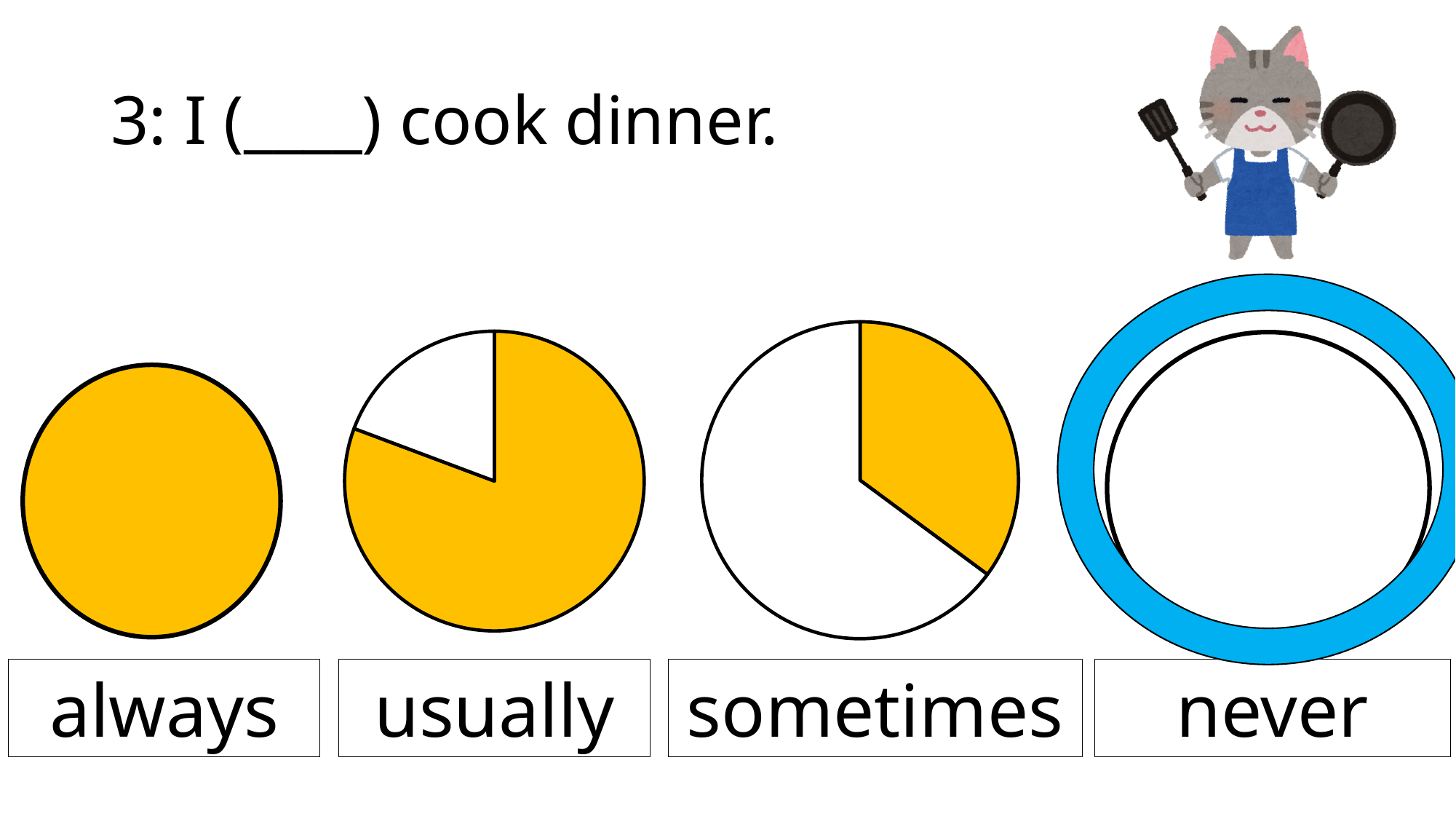
Which frequency word's circle has no filled portion at all? never Which frequency word's circle is highlighted with a blue ring? never Which circle has a larger filled portion, the one labelled usually or the one labelled sometimes? usually How many circle charts are shown on the slide? 4 Is the filled portion of the circle labelled usually greater or less than half of the circle? greater What kind of chart is used to show the frequency words on the slide? pie chart Which circle has a smaller filled portion, the one labelled always or the one labelled sometimes? sometimes What colour is the filled portion of the circles? yellow Reading the circles from left to right, does the filled portion increase or decrease? decrease Is the filled portion of the circle labelled sometimes greater or less than half of the circle? less Which frequency word's circle is completely filled in? always